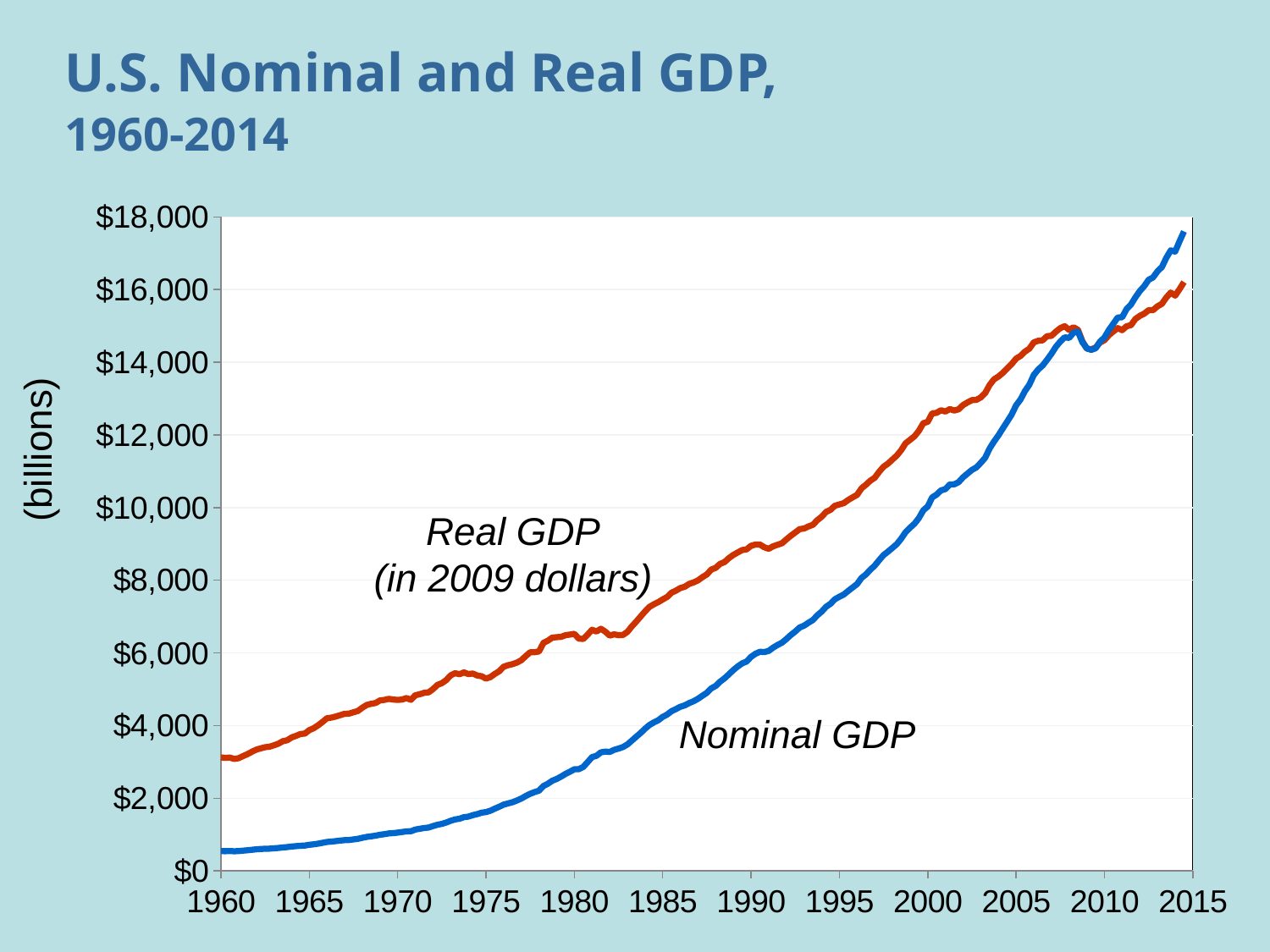
What is the title of the chart on the slide? U.S. Nominal and Real GDP, 1960-2014 In 2014, which is larger, Real GDP or Nominal GDP? Nominal GDP How many data series are plotted on the chart? 2 Is the value for Nominal GDP in 1960 greater or less than $2,000? less Is the value for Nominal GDP in 2014 greater or less than $16,000? greater Does Nominal GDP rise or fall from 1960 to 2014? Rise Is the value for Nominal GDP in 1980 greater or less than $4,000? less What kind of chart is shown on the slide? Line chart In 1990, which is larger, Real GDP or Nominal GDP? Real GDP What colour is the Nominal GDP line? Blue